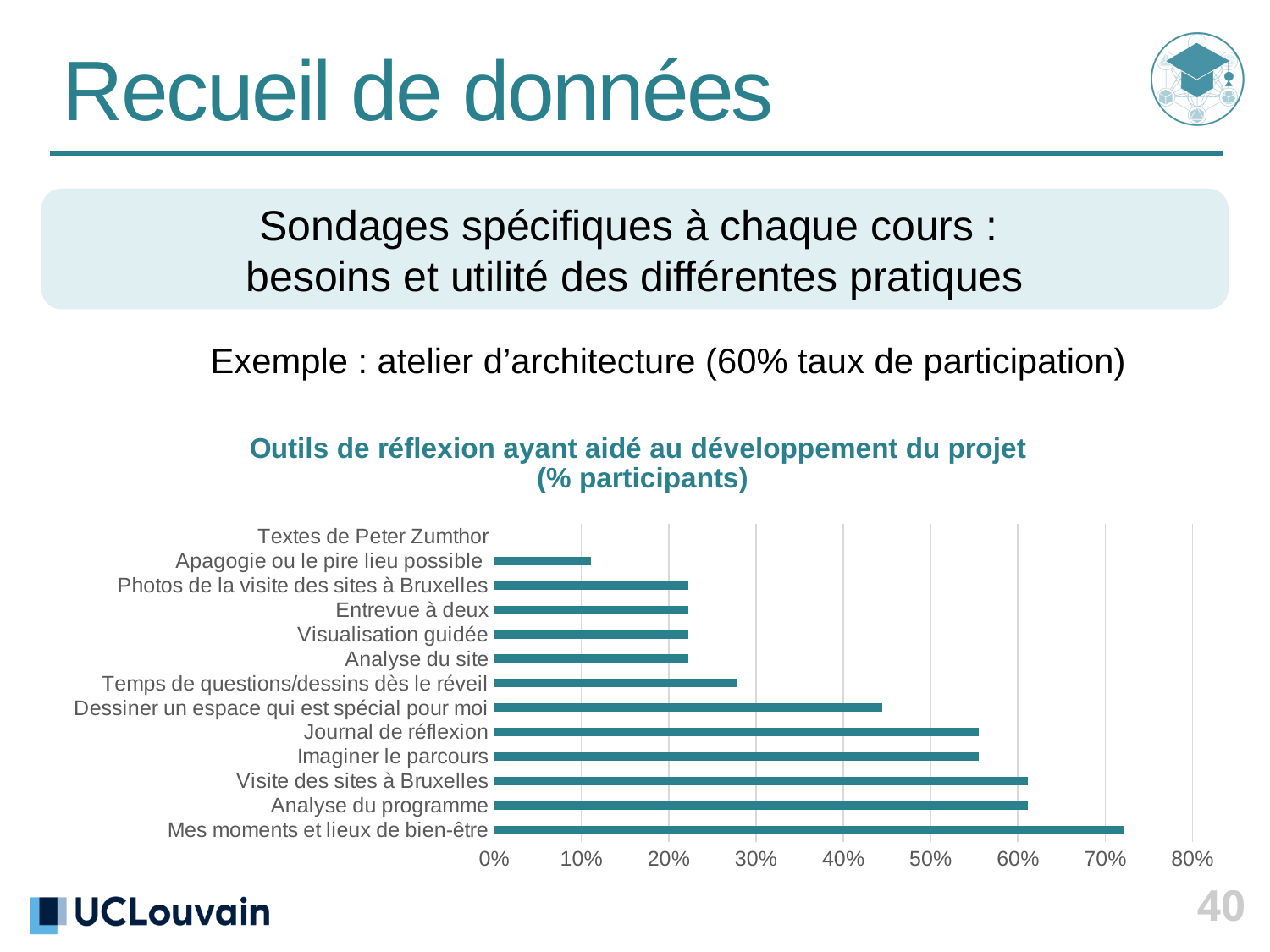
Is the value for Mes moments et lieux de bien-être greater or less than 60%? greater What kind of chart is shown on the slide? Bar chart What is the title of the chart? Outils de réflexion ayant aidé au développement du projet (% participants) Which is larger: the value for Mes moments et lieux de bien-être or the value for Visite des sites à Bruxelles? Mes moments et lieux de bien-être How many categories (reflection tools) are listed on the chart? 13 Is the value for Apagogie ou le pire lieu possible greater or less than 20%? less Which is larger: the value for Dessiner un espace qui est spécial pour moi or the value for Apagogie ou le pire lieu possible? Dessiner un espace qui est spécial pour moi Which category has the highest value? Mes moments et lieux de bien-être Which category has the lowest value? Textes de Peter Zumthor Is the value for Dessiner un espace qui est spécial pour moi greater or less than 40%? greater